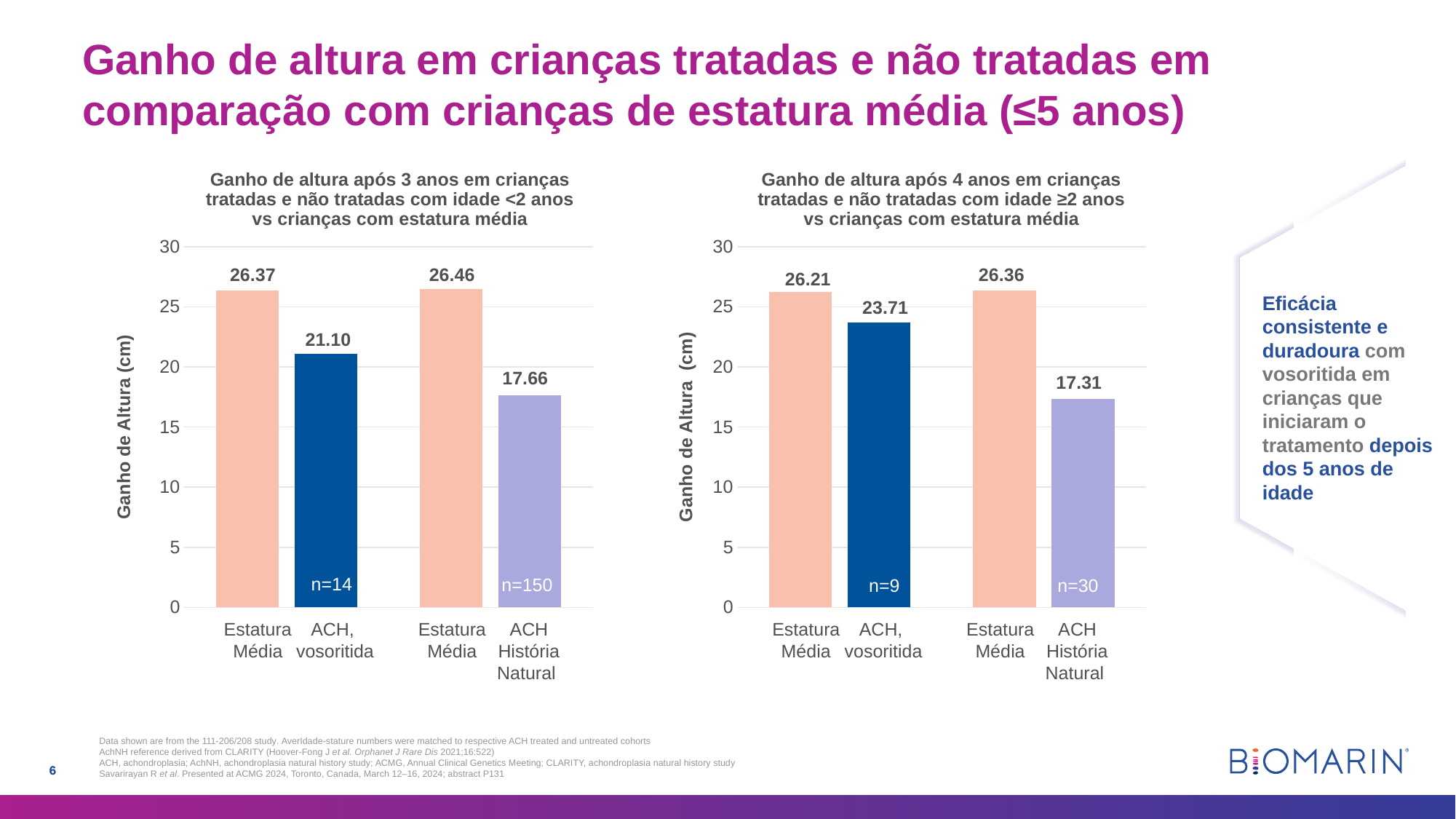
In the right chart (height gain after 4 years, age ≥2), what is the value for ACH, vosoritida? 23.71 In the left chart (height gain after 3 years, age <2), which category has the lowest value? ACH História Natural In the right chart (height gain after 4 years, age ≥2), what is the difference between ACH, vosoritida and ACH História Natural? 6.40 What type of chart is the left chart (height gain after 3 years, age <2)? Bar chart In the left chart (height gain after 3 years, age <2), what is the value for ACH História Natural? 17.66 In the right chart (height gain after 4 years, age ≥2), which category has the lowest value? ACH História Natural In the right chart (height gain after 4 years, age ≥2), which is larger: ACH, vosoritida or ACH História Natural? ACH, vosoritida In the left chart (height gain after 3 years, age <2), what is the value for ACH, vosoritida? 21.10 In the right chart (height gain after 4 years, age ≥2), what is the value for ACH História Natural? 17.31 In the left chart (height gain after 3 years, age <2), what is the difference between ACH, vosoritida and ACH História Natural? 3.44 In the left chart (height gain after 3 years, age <2), is the value for ACH, vosoritida greater or less than 20? greater How many bars are plotted in the right chart (height gain after 4 years, age ≥2)? 4